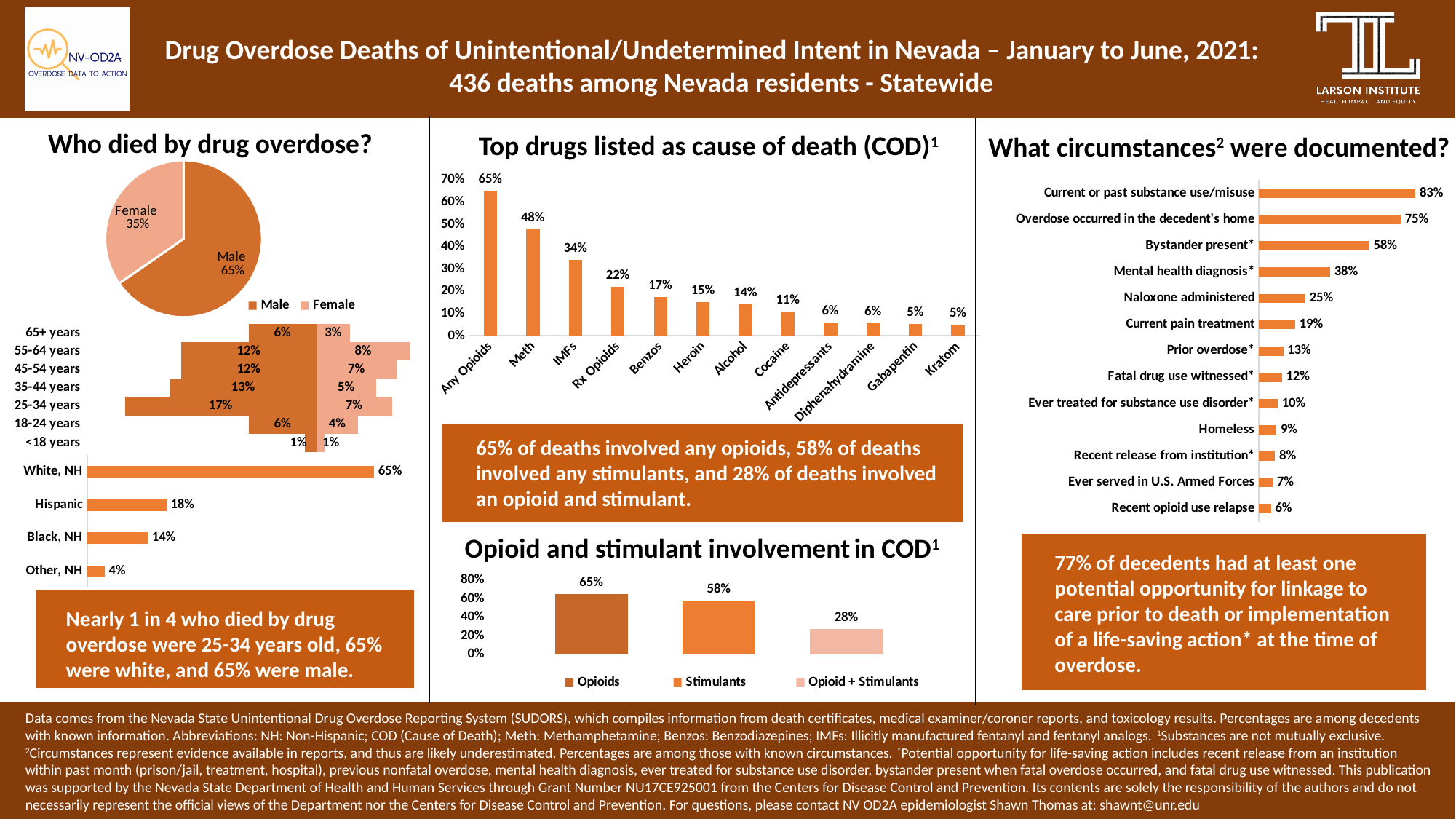
What type of chart is used for 'Opioid and stimulant involvement in COD'? Bar chart In the age pyramid under 'Who died by drug overdose?', what percentage of males were 25-34 years old? 17% In the race/ethnicity bar chart under 'Who died by drug overdose?', what percentage is shown for Hispanic? 18% In the 'Opioid and stimulant involvement in COD' chart, how many series does the legend list? 3 In the pie chart under 'Who died by drug overdose?', what share of deaths were Female? 35% In the 'Top drugs listed as cause of death (COD)' chart, what percentage is shown for Meth? 48% In the 'Top drugs listed as cause of death (COD)' chart, which drug has the highest percentage? Any Opioids In the 'Top drugs listed as cause of death (COD)' chart, what is the difference between the percentages for IMFs and Rx Opioids? 12% In the 'What circumstances were documented?' chart, which circumstance has the lowest percentage? Recent opioid use relapse In the 'What circumstances were documented?' chart, which is larger: Bystander present or Mental health diagnosis? Bystander present In the 'Top drugs listed as cause of death (COD)' chart, how many drug categories are shown? 12 In the 'What circumstances were documented?' chart, what percentage is shown for Naloxone administered? 25%